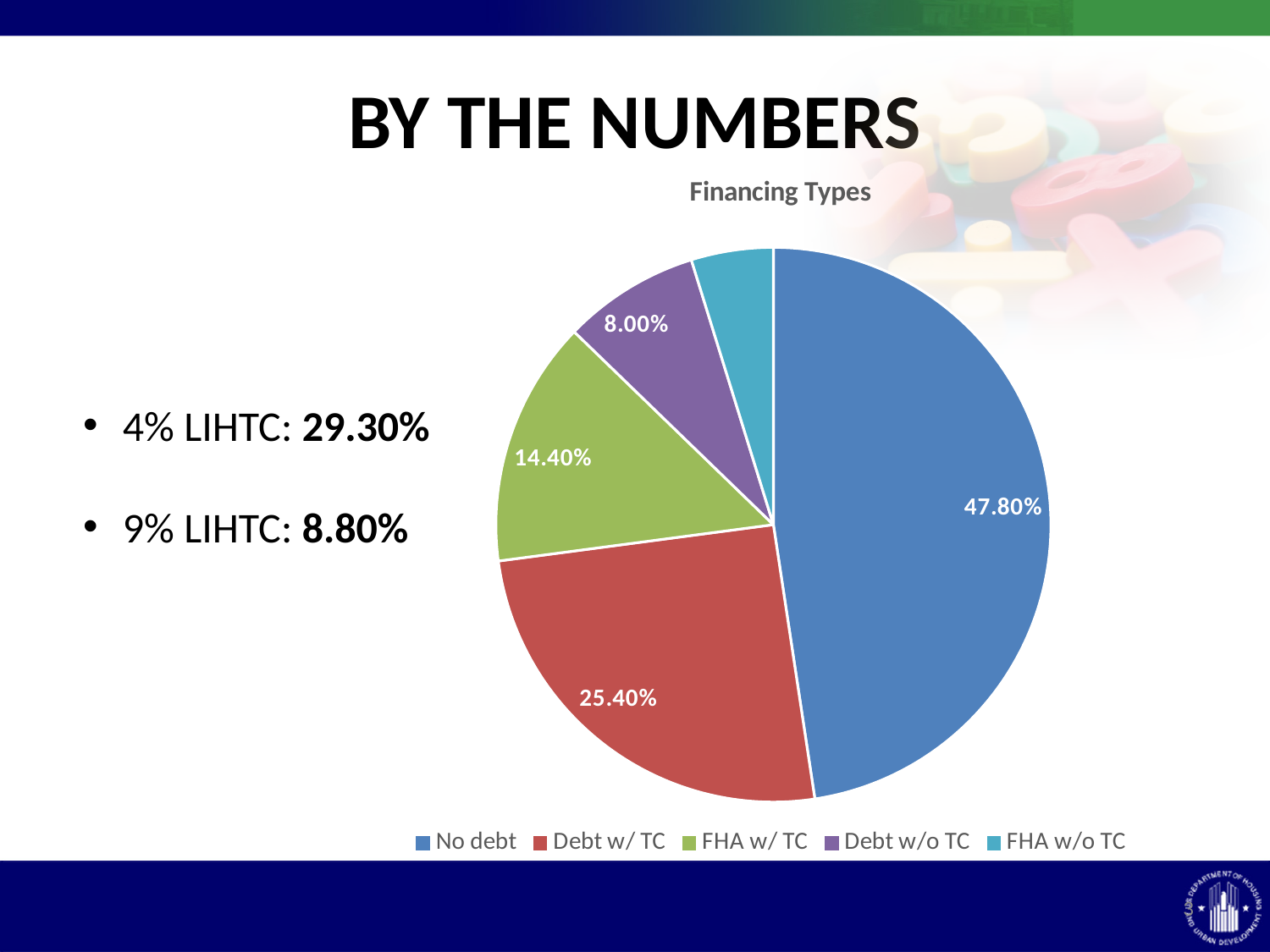
Which financing type has the smallest slice of the pie? FHA w/o TC Which financing type has the largest slice of the pie? No debt What share of the pie does FHA w/ TC account for? 14.40% What share of the pie does No debt account for? 47.80% What is the difference between the No debt share and the Debt w/ TC share? 22.40% What share of the pie does Debt w/ TC account for? 25.40% Which is larger, the FHA w/ TC slice or the Debt w/o TC slice? FHA w/ TC How many slices does the pie chart have? 5 How many entries does the chart legend list? 5 What kind of chart is shown on the slide? pie chart What is the title of the chart? Financing Types What share of the pie does Debt w/o TC account for? 8.00%